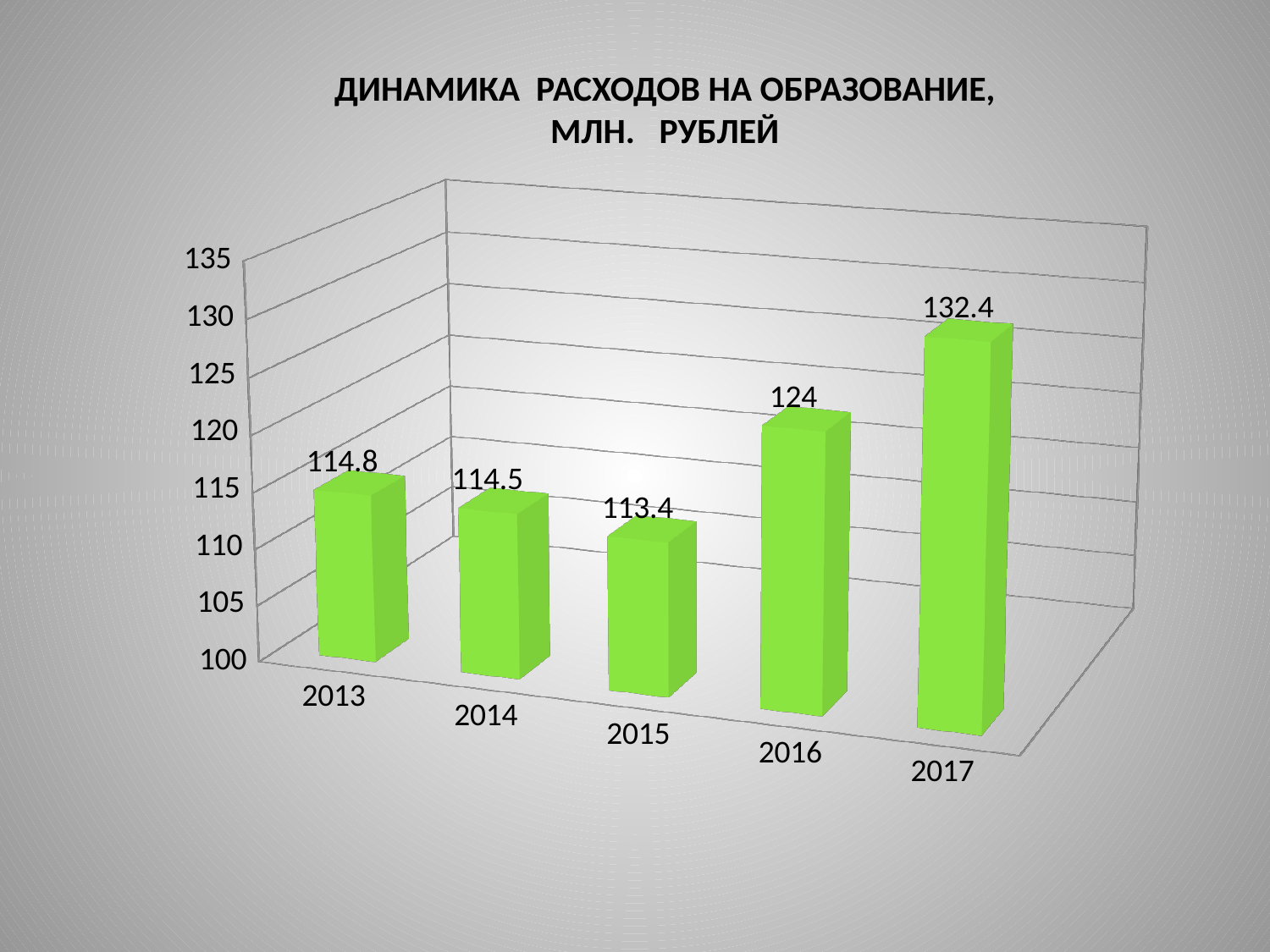
What kind of chart is shown on the slide? bar chart How many years are shown on the x axis? 5 Which year has the highest value? 2017 What is the difference between the values for 2017 and 2016? 8.4 What is the value for 2015? 113.4 Is the value for 2016 greater or less than 120? greater What is the value for 2013? 114.8 Which year has the lowest value? 2015 What is the difference between the values for 2013 and 2015? 1.4 What is the value for 2017? 132.4 What is the title of the chart? ДИНАМИКА РАСХОДОВ НА ОБРАЗОВАНИЕ, МЛН. РУБЛЕЙ Which is larger, the value for 2016 or the value for 2014? 2016